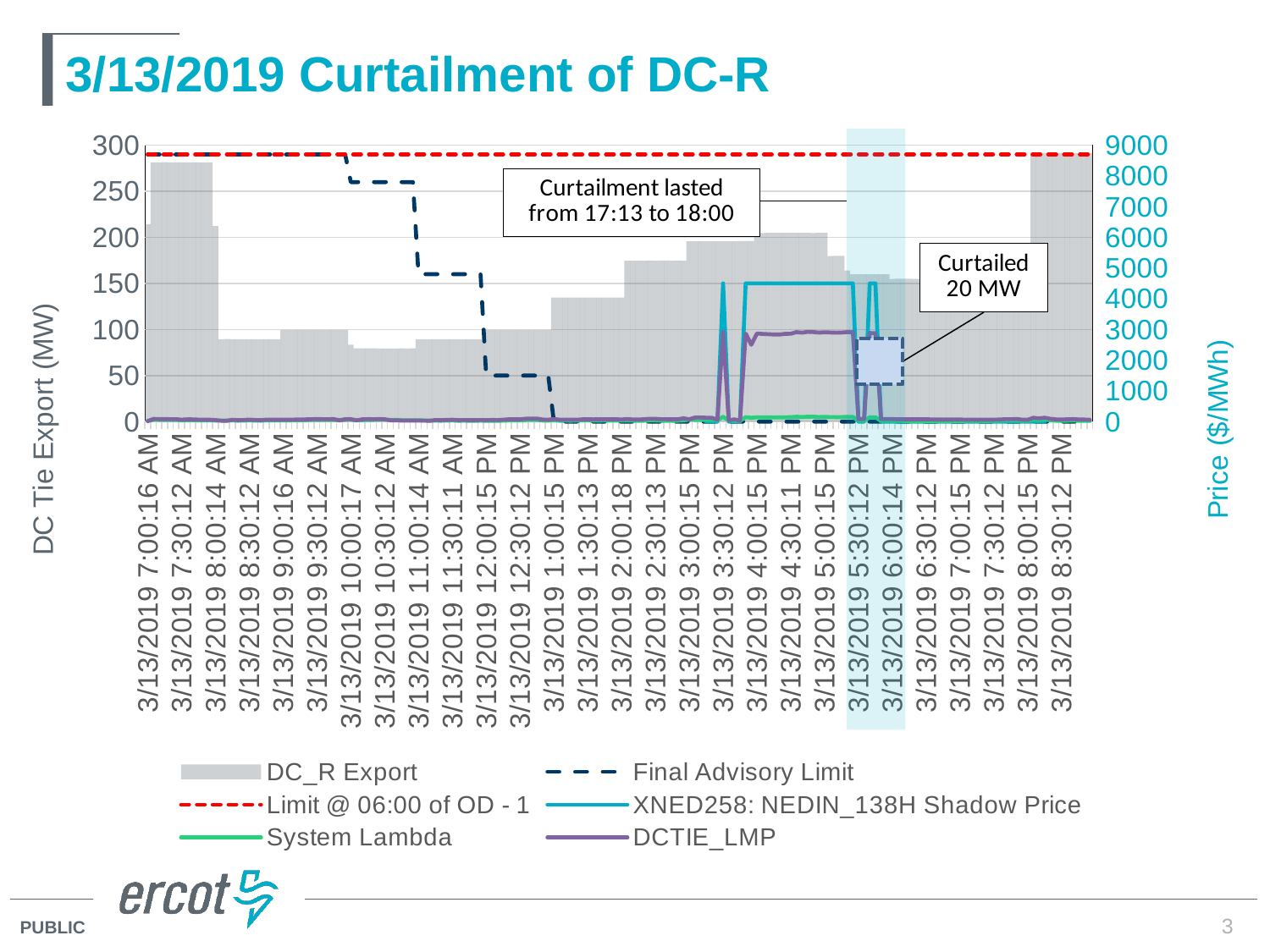
Is the Limit @ 06:00 of OD - 1 greater or less than 250 MW? greater Does the Final Advisory Limit rise or fall over the course of the morning from 10:00 AM to 1:00 PM? fall Is the peak of the XNED258: NEDIN_138H Shadow Price greater or less than 4000 $/MWh? greater According to the annotation on the chart, during what time period did the curtailment last? From 17:13 to 18:00 What is the label of the right-hand vertical axis? Price ($/MWh) How many series does the chart's legend list? 6 According to the annotation on the chart, how much was curtailed? 20 MW What is the title of the chart on the slide? 3/13/2019 Curtailment of DC-R Is the DCTIE_LMP value at 3/13/2019 4:30:11 PM greater or less than 2000 $/MWh? greater What kind of chart is shown on the slide? Combination bar and line chart